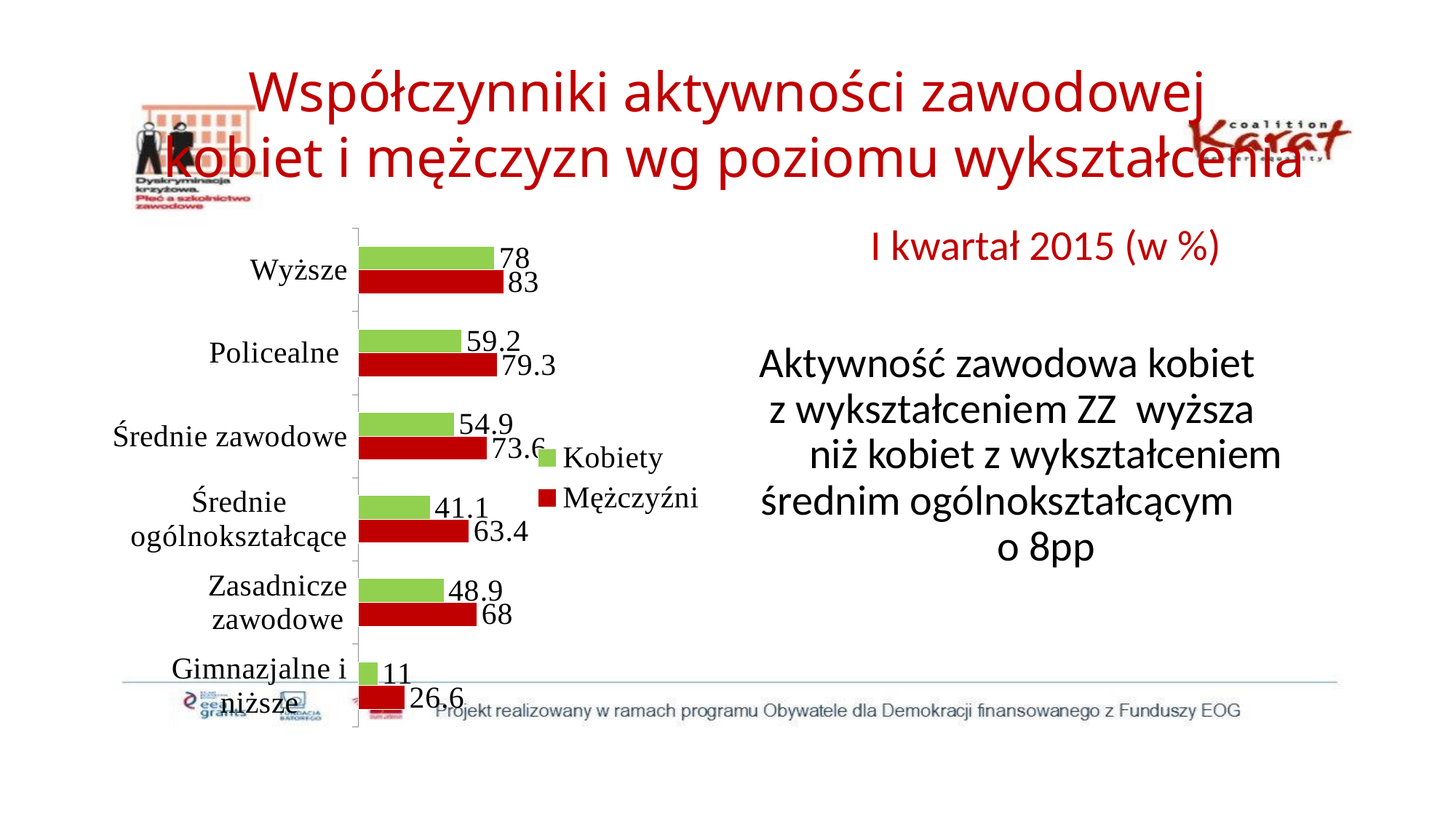
Which category has the lowest value for Kobiety? Gimnazjalne i niższe How many series does the legend list? 2 How many education-level categories are shown on the chart? 6 What is the value for Mężczyźni in the Policealne category? 79.3 What is the difference between the Mężczyźni and Kobiety values in the Zasadnicze zawodowe category? 19.1 Which is larger in the Średnie zawodowe category, the value for Kobiety or for Mężczyźni? Mężczyźni What is the value for Kobiety in the Średnie ogólnokształcące category? 41.1 Which colour represents the Kobiety series in the chart? Green What kind of chart is shown on the slide? Bar chart Which category has the highest value for Mężczyźni? Wyższe What is the value for Kobiety in the Wyższe category? 78 What is the value for Mężczyźni in the Gimnazjalne i niższe category? 26,6